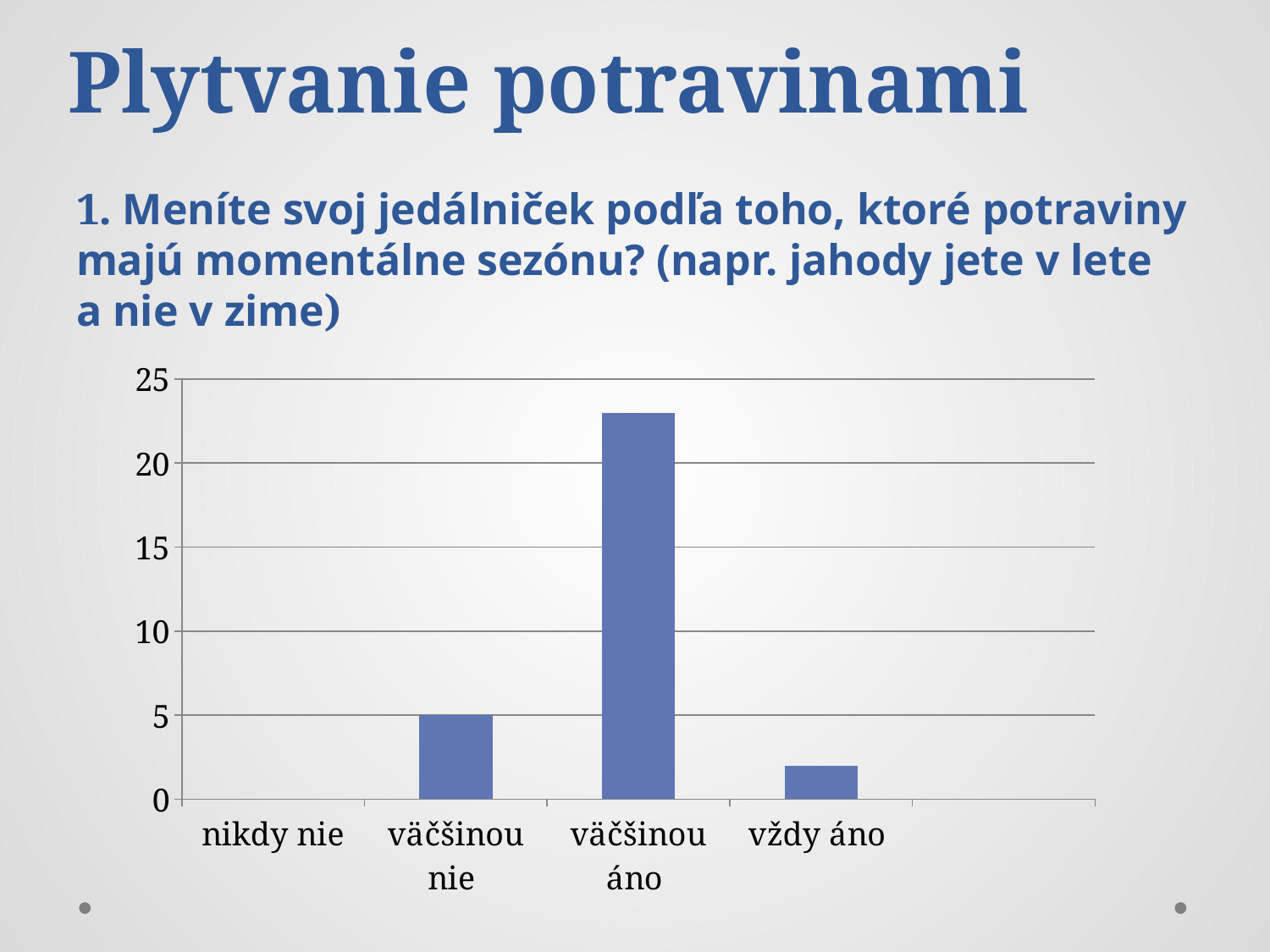
What is the value for "väčšinou nie" in the chart? 5 Is the value for "väčšinou áno" greater or less than 20? greater Which is larger, the value for "väčšinou nie" or the value for "vždy áno"? väčšinou nie Is the value for "vždy áno" greater or less than 5? less Is the value for "väčšinou áno" greater or less than 25? less What colour are the bars in the chart? blue Does the value rise or fall from "väčšinou áno" to "vždy áno"? fall What kind of chart is shown on the slide? bar chart What is the value for "nikdy nie" in the chart? 0 How many categories are shown on the x axis of the chart? 4 Which category has the highest bar in the chart? väčšinou áno Which category has the lowest value in the chart? nikdy nie